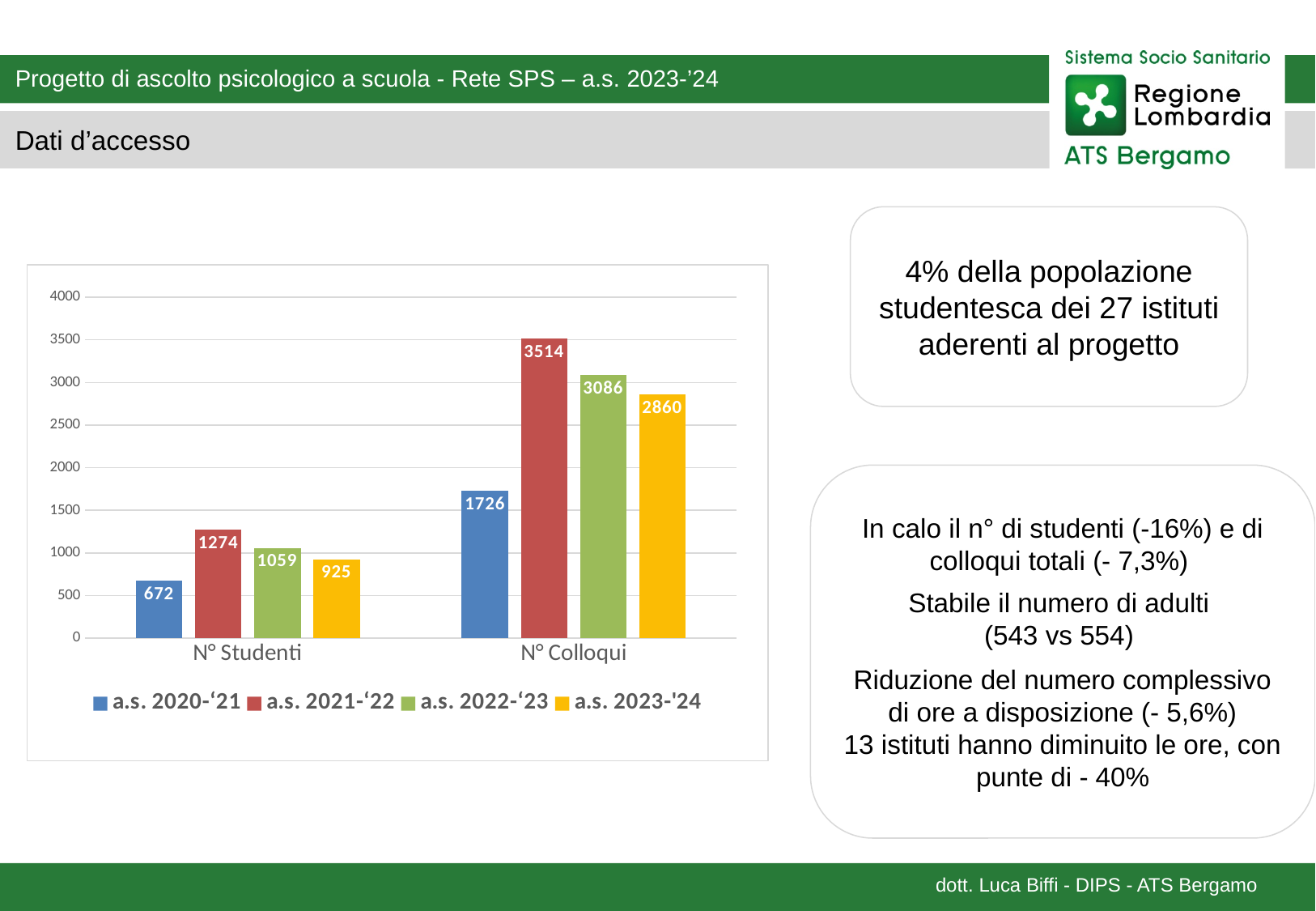
How many series does the legend list? 4 What is the value for N° Colloqui in a.s. 2023-'24? 2860 What is the difference between N° Studenti in a.s. 2022-'23 and a.s. 2023-'24? 134 Which is larger: N° Studenti in a.s. 2021-'22 or in a.s. 2022-'23? a.s. 2021-'22 Which colour represents a.s. 2023-'24 in the chart? Yellow What is the value for N° Studenti in a.s. 2020-'21? 672 Which school year has the lowest value for N° Colloqui? a.s. 2020-'21 Which school year has the highest value for N° Studenti? a.s. 2021-'22 Is the value for N° Colloqui in a.s. 2022-'23 greater or less than 3000? greater What is the value for N° Colloqui in a.s. 2021-'22? 3514 What is the difference between N° Colloqui in a.s. 2021-'22 and a.s. 2022-'23? 428 What kind of chart is shown on the slide? Bar chart